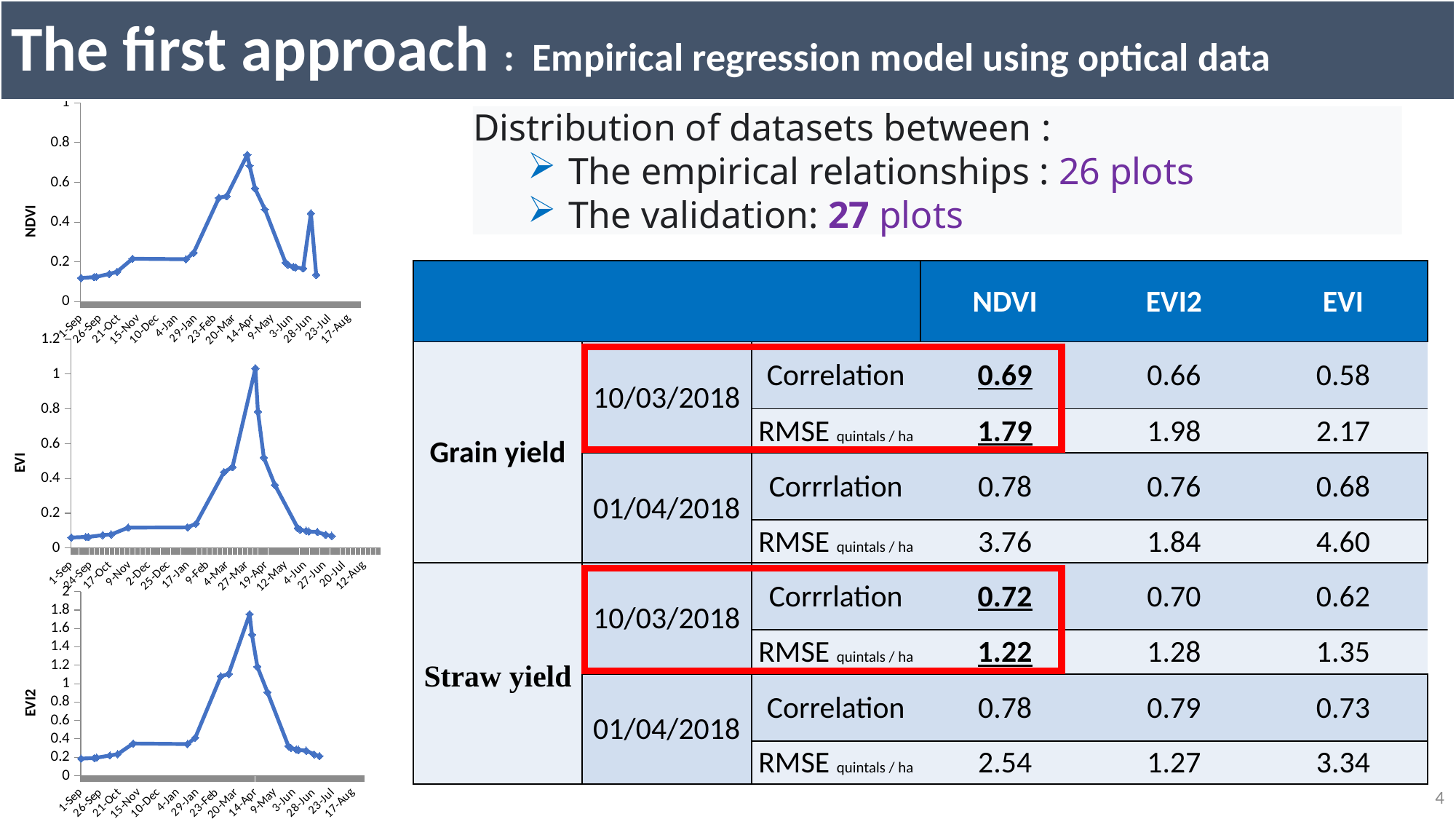
What is the y-axis label of the bottom-left chart? EVI2 In the EVI2 chart, is the peak value greater or less than 1.4? greater In the EVI chart, is the peak value greater or less than 0.8? greater In the EVI2 chart, is the value at 1-Sep greater or less than 0.4? less What is the y-axis label of the middle chart on the left? EVI In the EVI2 chart, do the values rise or fall between 14-Apr and 3-Jun? fall What kind of chart is the top-left chart labelled NDVI? line chart How many charts are shown on the left side of the slide? 3 In the NDVI chart, do the values rise or fall between 29-Jan and 14-Apr? rise